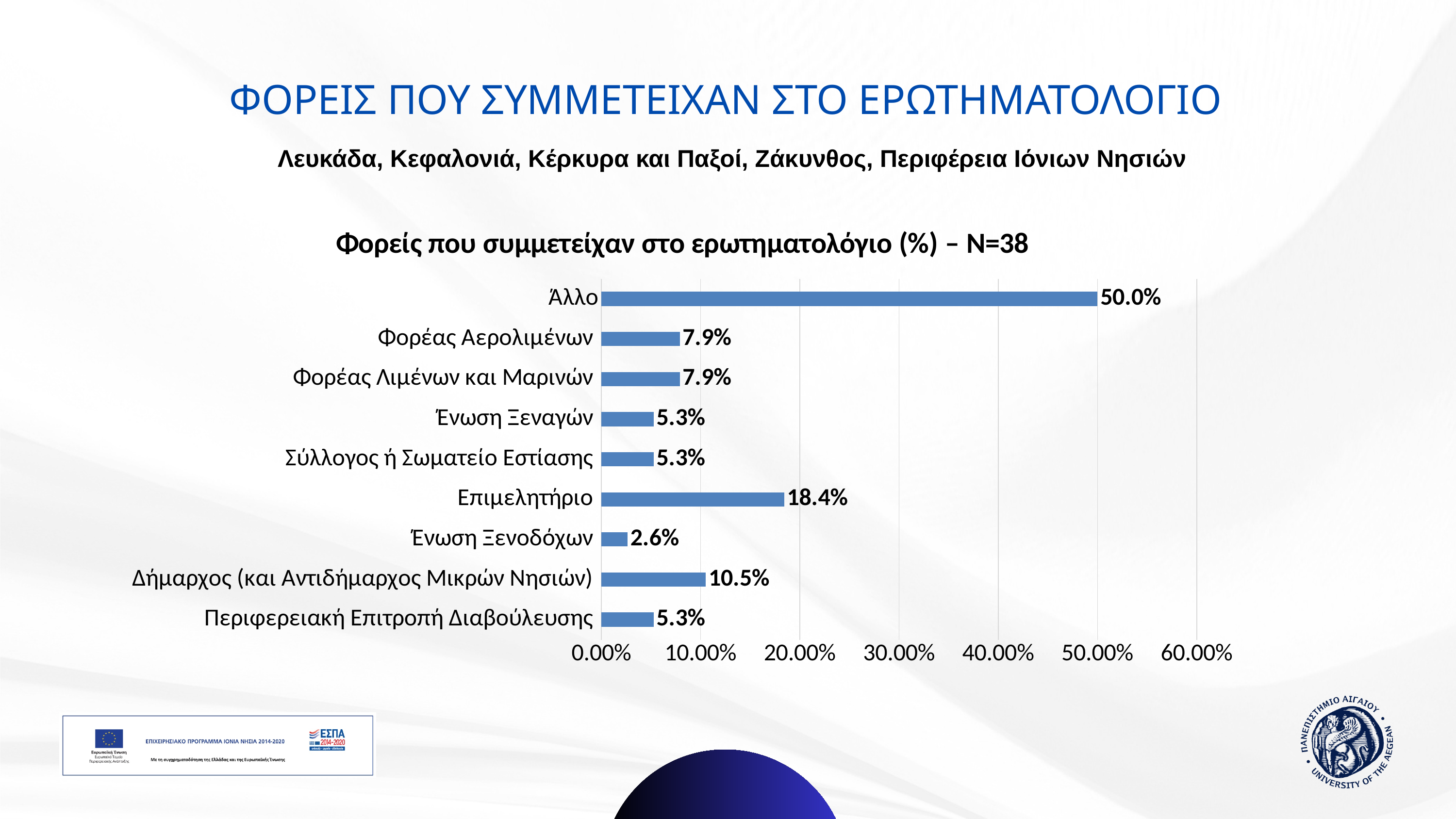
What is the value for Δήμαρχος (και Αντιδήμαρχος Μικρών Νησιών)? 10.5% What is the difference between the values for Άλλο and Επιμελητήριο? 31.6% Which category has the highest value? Άλλο What is the value for Ένωση Ξενοδόχων? 2.6% Which is larger, the value for Επιμελητήριο or the value for Δήμαρχος (και Αντιδήμαρχος Μικρών Νησιών)? Επιμελητήριο What is the title of the chart? Φορείς που συμμετείχαν στο ερωτηματολόγιο (%) – N=38 What is the value for Άλλο? 50.0% How many categories are shown in the chart? 9 Is the value for Φορέας Αερολιμένων greater or less than 10.00%? less What kind of chart is shown on the slide? bar chart What is the value for Επιμελητήριο? 18.4% Which category has the lowest value? Ένωση Ξενοδόχων